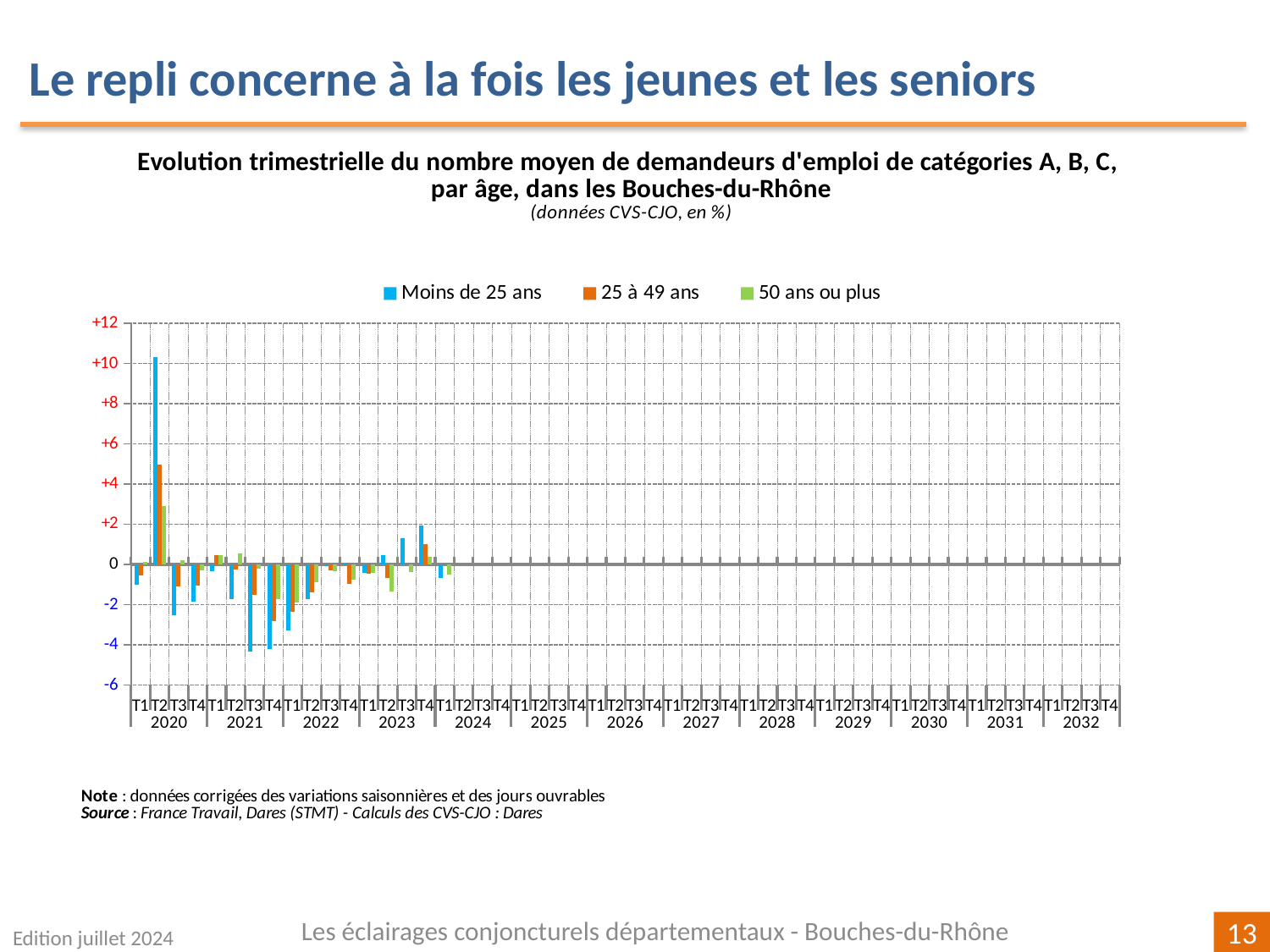
How many years are labelled along the x axis of the chart? 13 Is the value for 50 ans ou plus in T2 2020 greater or less than +2? greater How many series does the legend list? 3 Is the value for Moins de 25 ans in T3 2021 greater or less than -2? less In T3 2021, which is larger: the value for Moins de 25 ans or for 25 à 49 ans? 25 à 49 ans Is the value for 25 à 49 ans in T2 2020 greater or less than +6? less What kind of chart is shown on the slide? bar chart In T2 2020, which is larger: the value for Moins de 25 ans or for 25 à 49 ans? Moins de 25 ans Which series and quarter has the highest value in the chart? Moins de 25 ans, T2 2020 Which colour represents the series 'Moins de 25 ans' in the legend? blue